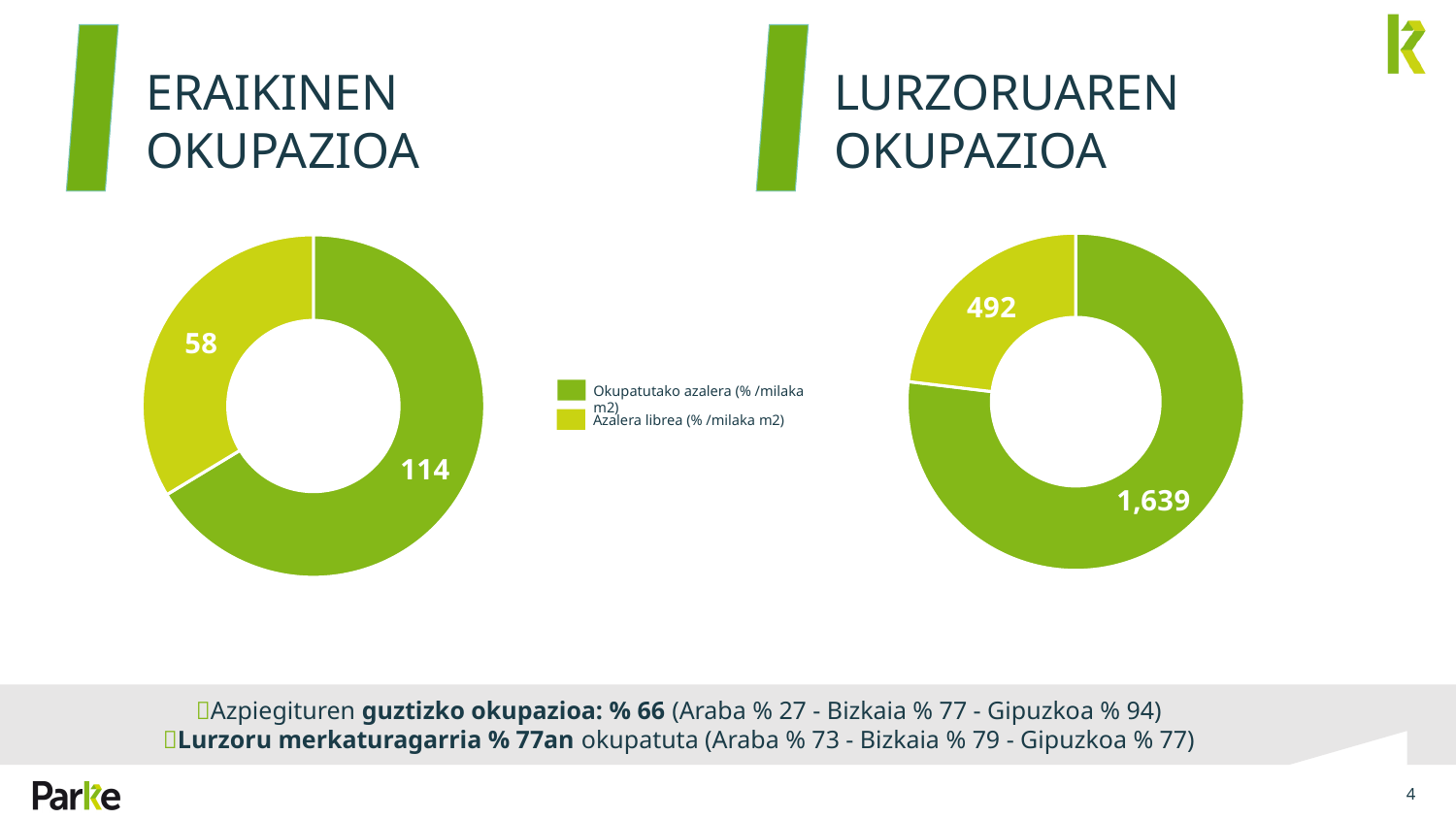
In the ERAIKINEN OKUPAZIOA chart, what is the difference between Okupatutako azalera and Azalera librea? 56 In the LURZORUAREN OKUPAZIOA chart, which is larger: Okupatutako azalera or Azalera librea? Okupatutako azalera In the ERAIKINEN OKUPAZIOA chart, what is the value for Okupatutako azalera? 114 In the ERAIKINEN OKUPAZIOA chart, which category has the largest value? Okupatutako azalera In the LURZORUAREN OKUPAZIOA chart, which category has the smallest value? Azalera librea How many entries does the legend between the two charts list? 2 In the ERAIKINEN OKUPAZIOA chart, what is the value for Azalera librea? 58 How many slices does the LURZORUAREN OKUPAZIOA chart have? 2 What kind of chart is the ERAIKINEN OKUPAZIOA chart? Doughnut chart In the LURZORUAREN OKUPAZIOA chart, what is the value for Okupatutako azalera? 1,639 In the LURZORUAREN OKUPAZIOA chart, what is the value for Azalera librea? 492 In the LURZORUAREN OKUPAZIOA chart, what is the difference between Okupatutako azalera and Azalera librea? 1,147